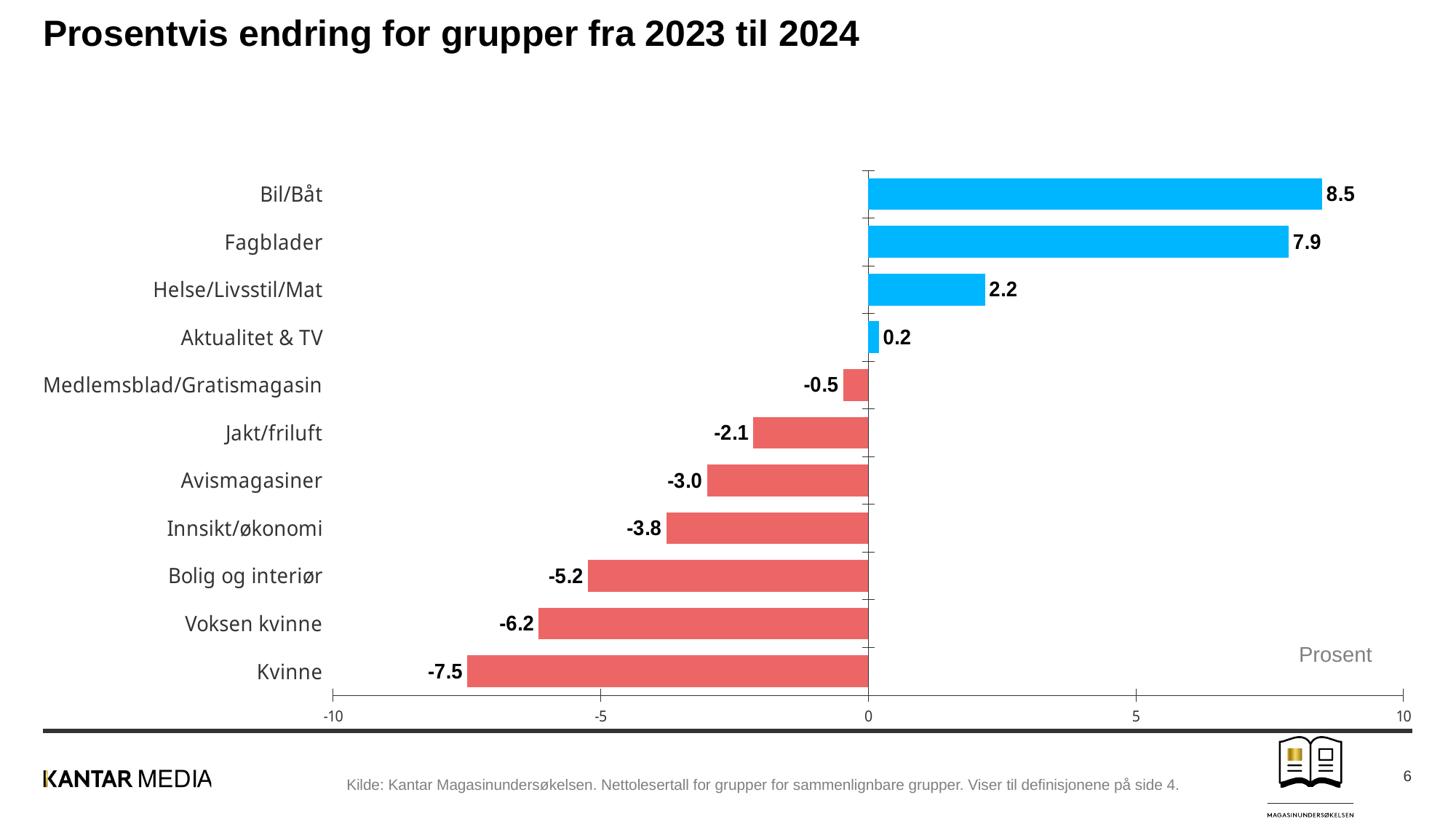
What is the percentage change for Bil/Båt? 8.5 Which group has the highest percentage change? Bil/Båt Is the value for Voksen kvinne greater or less than -5? less How many groups are shown in the chart? 11 What is the value shown for Innsikt/økonomi? -3.8 Which group has the lowest percentage change? Kvinne Which has a larger percentage change, Helse/Livsstil/Mat or Aktualitet & TV? Helse/Livsstil/Mat What is the percentage change for Kvinne? -7.5 What is the difference between the values for Bil/Båt and Fagblader? 0.6 How many groups have a negative percentage change? 7 What is the title of the chart? Prosentvis endring for grupper fra 2023 til 2024 What kind of chart is shown on the slide? Bar chart